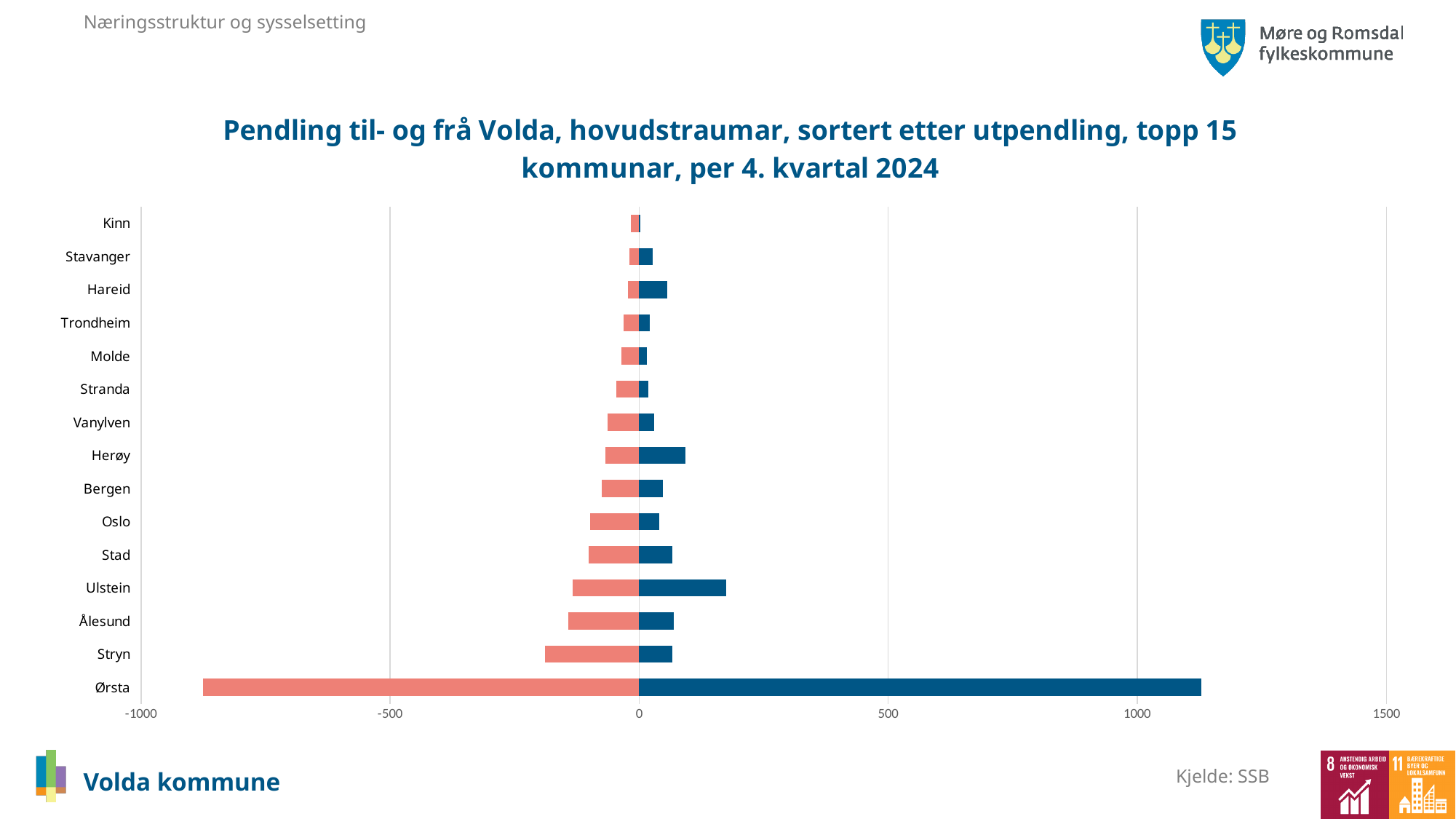
Which has the larger blue (positive) bar, Ulstein or Herøy? Ulstein Which has the longer red (negative) bar, Stryn or Oslo? Stryn Which municipality has the longest red (negative) bar in the chart? Ørsta What kind of chart is shown on the slide? bar chart Is the red (negative) value for Ørsta greater or less than -500? less How many municipalities are listed on the vertical axis of the chart? 15 What is the title of the chart? Pendling til- og frå Volda, hovudstraumar, sortert etter utpendling, topp 15 kommunar, per 4. kvartal 2024 Which municipality has the shortest red (negative) bar in the chart? Kinn Is the blue (positive) value for Ørsta greater or less than 1000? greater Is the red (negative) value for Stryn greater or less than -500? greater Which municipality has the longest blue (positive) bar in the chart? Ørsta